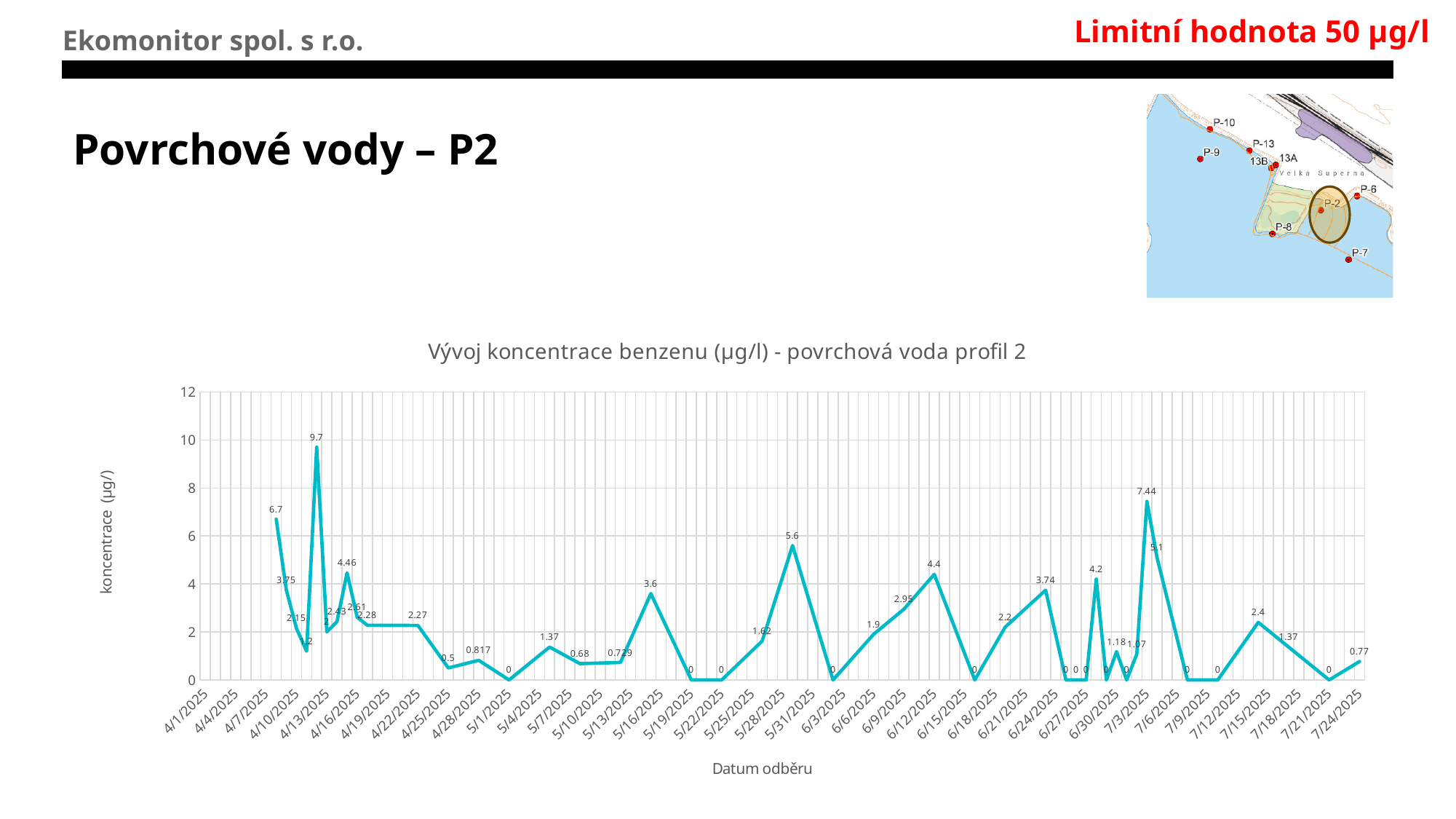
Which is larger: the first plotted value (6.7) or the last plotted value (0.77)? the first value, 6.7 What is the maximum value shown on the y axis? 12 Is the highest plotted value greater or less than 8? greater What is the title of the chart? Vývoj koncentrace benzenu (µg/l) - povrchová voda profil 2 What kind of chart is shown on the slide? line chart What is the difference between the first plotted value (6.7) and the last plotted value (0.77)? 5.93 What is the highest benzene concentration value plotted on the chart? 9.7 What is the difference between the highest plotted value (9.7) and the second-highest peak (7.44)? 2.26 Comparing the first plotted point (6.7) with the last plotted point (0.77), does the concentration overall rise or fall? fall What is the value of the last plotted point, at 7/24/2025? 0.77 What is the lowest value plotted on the chart? 0 Is the peak value of 7.44 greater or less than 6? greater